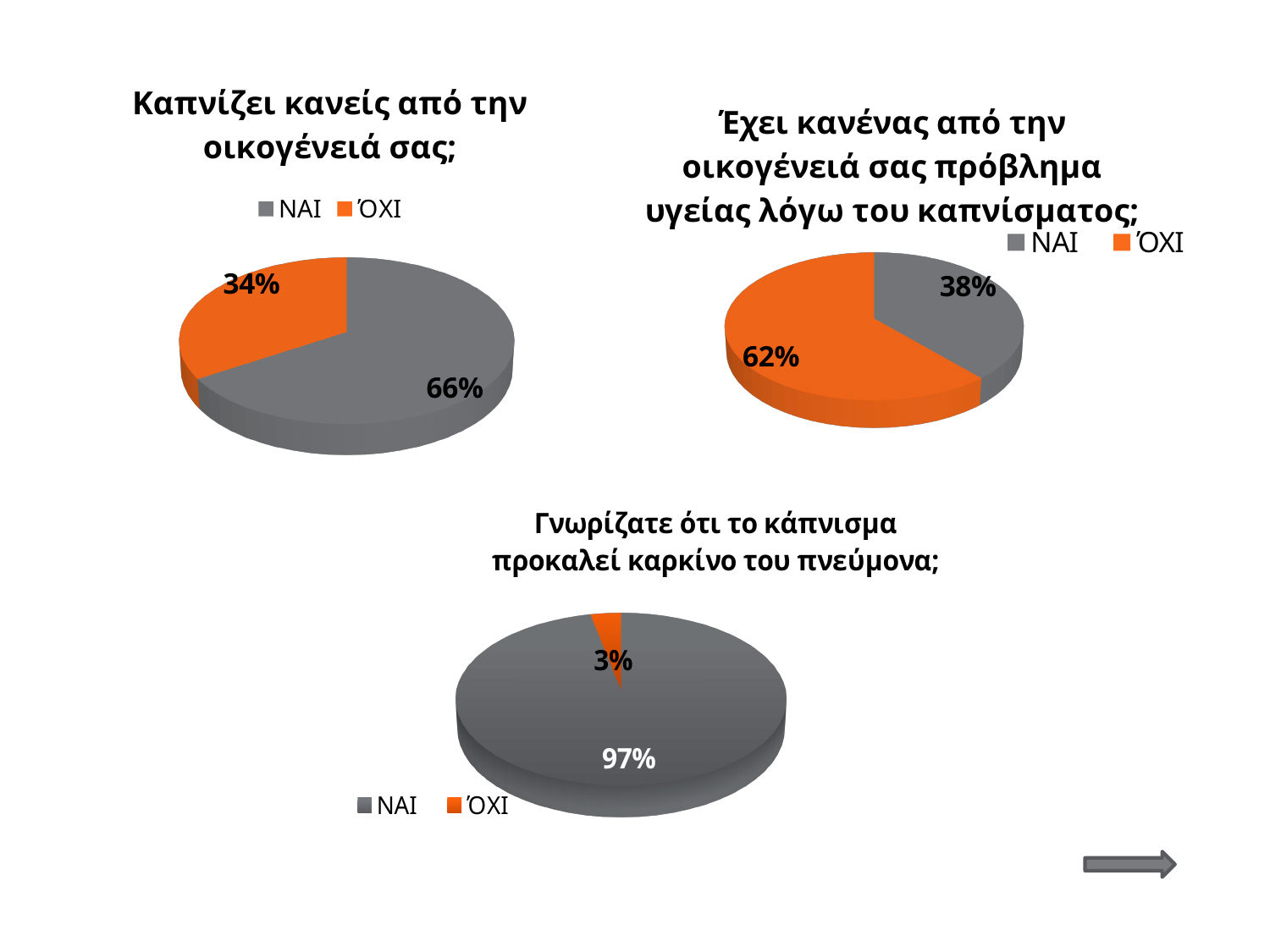
In the bottom chart titled 'Γνωρίζατε ότι το κάπνισμα προκαλεί καρκίνο του πνεύμονα;', which is larger, ΝΑΙ or ΌΧΙ? ΝΑΙ How many entries does the legend of the top-right chart titled 'Έχει κανένας από την οικογένειά σας πρόβλημα υγείας λόγω του καπνίσματος;' list? 2 In the top-left chart titled 'Καπνίζει κανείς από την οικογένειά σας;', what is the difference between the ΝΑΙ and ΌΧΙ shares? 32% In the top-left chart titled 'Καπνίζει κανείς από την οικογένειά σας;', what share of the pie is ΝΑΙ? 66% In the top-right chart titled 'Έχει κανένας από την οικογένειά σας πρόβλημα υγείας λόγω του καπνίσματος;', what share of the pie is ΝΑΙ? 38% What kind of chart is the bottom chart titled 'Γνωρίζατε ότι το κάπνισμα προκαλεί καρκίνο του πνεύμονα;'? Pie chart In the bottom chart titled 'Γνωρίζατε ότι το κάπνισμα προκαλεί καρκίνο του πνεύμονα;', what share of the pie is ΌΧΙ? 3% In the top-left chart titled 'Καπνίζει κανείς από την οικογένειά σας;', which slice is the largest? ΝΑΙ In the top-right chart titled 'Έχει κανένας από την οικογένειά σας πρόβλημα υγείας λόγω του καπνίσματος;', which slice is the smallest? ΝΑΙ